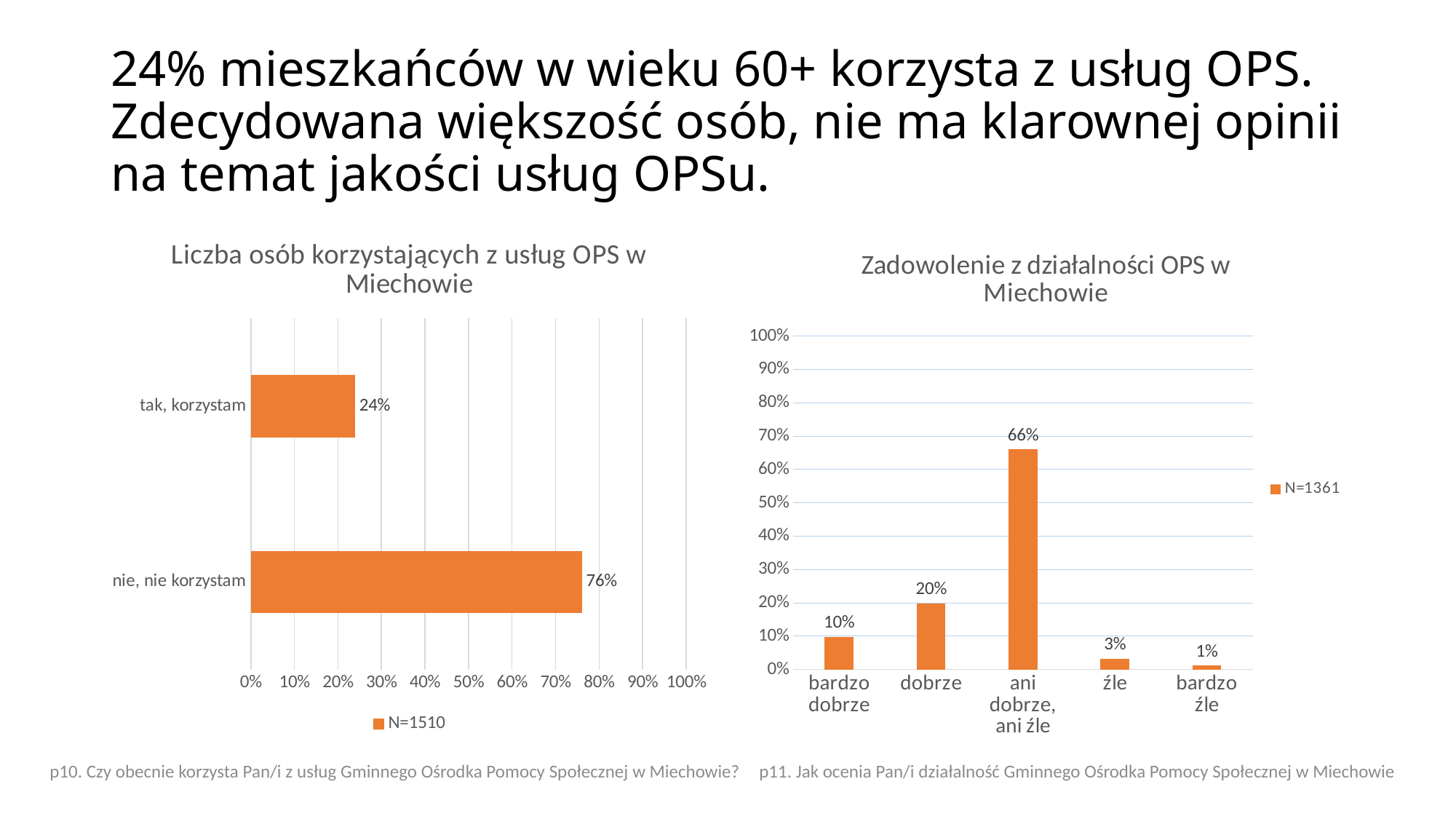
In the chart 'Zadowolenie z działalności OPS w Miechowie', which category has the lowest value? bardzo źle In the chart 'Liczba osób korzystających z usług OPS w Miechowie', what is the value for 'nie, nie korzystam'? 76% In the chart 'Zadowolenie z działalności OPS w Miechowie', what is the legend entry? N=1361 In the chart 'Liczba osób korzystających z usług OPS w Miechowie', what is the value for 'tak, korzystam'? 24% In the chart 'Zadowolenie z działalności OPS w Miechowie', how many categories are shown on the x axis? 5 In the chart 'Liczba osób korzystających z usług OPS w Miechowie', what is the difference between 'nie, nie korzystam' and 'tak, korzystam'? 52% What kind of chart is 'Liczba osób korzystających z usług OPS w Miechowie'? bar chart In the chart 'Zadowolenie z działalności OPS w Miechowie', what is the value for 'ani dobrze, ani źle'? 66% In the chart 'Zadowolenie z działalności OPS w Miechowie', what is the difference between 'dobrze' and 'bardzo dobrze'? 10% In the chart 'Zadowolenie z działalności OPS w Miechowie', which category has the highest value? ani dobrze, ani źle In the chart 'Zadowolenie z działalności OPS w Miechowie', what is the value for 'dobrze'? 20% In the chart 'Zadowolenie z działalności OPS w Miechowie', which is larger: 'źle' or 'bardzo dobrze'? bardzo dobrze